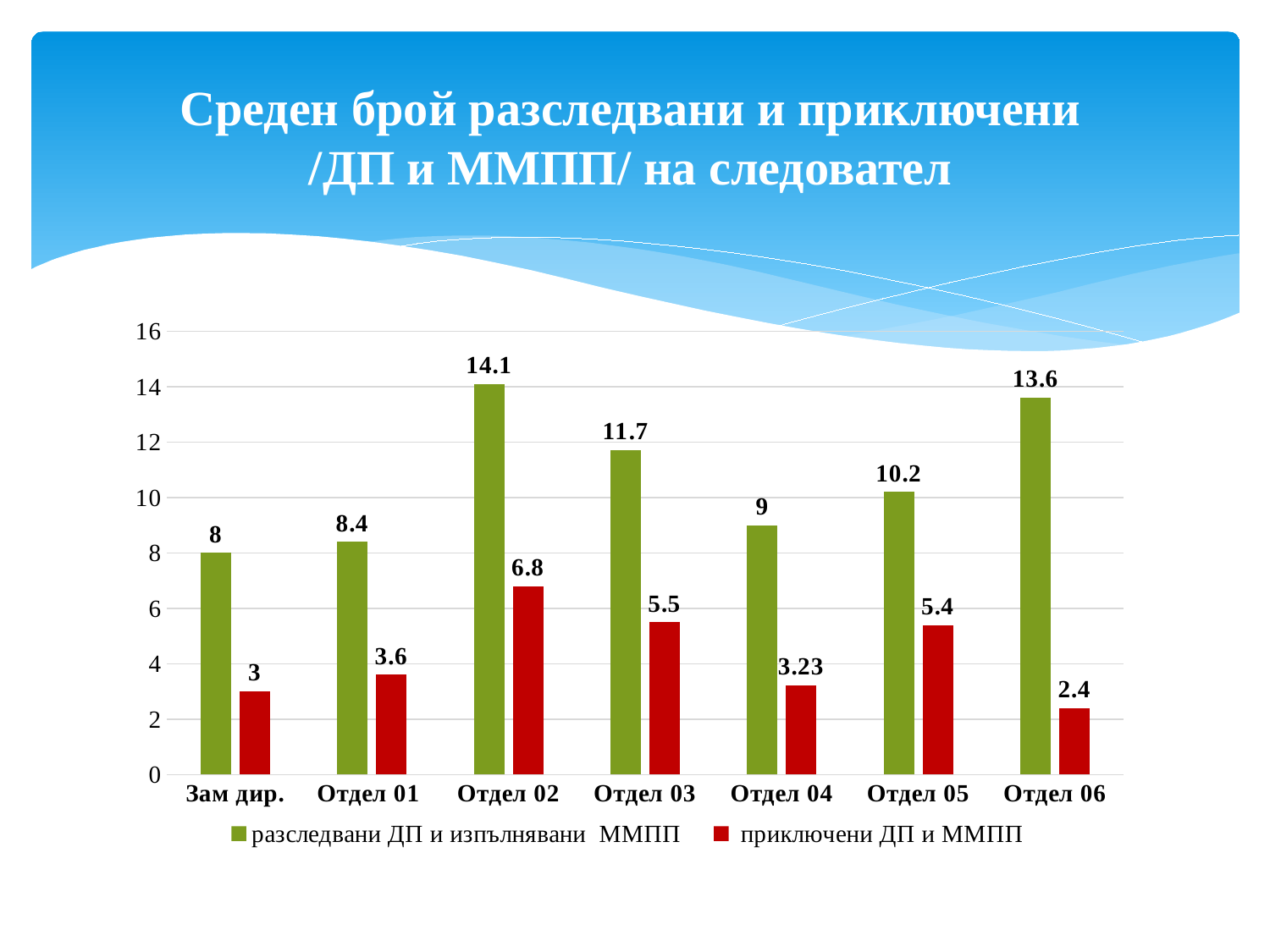
What kind of chart is shown on the slide? bar chart What is the value of "приключени ДП и ММПП" for Отдел 04? 3.23 What is the difference between the two series for Отдел 06? 11.2 What is the value of "приключени ДП и ММПП" for Зам дир.? 3 Which category has the highest value for "разследвани ДП и изпълнявани ММПП"? Отдел 02 Which category has the lowest value for "приключени ДП и ММПП"? Отдел 06 What is the value of "разследвани ДП и изпълнявани ММПП" for Отдел 02? 14.1 How many categories are shown on the x axis? 7 What colour are the bars for "приключени ДП и ММПП"? red Which is larger: "приключени ДП и ММПП" for Отдел 03 or for Отдел 05? Отдел 03 How many series does the legend list? 2 Is the value of "разследвани ДП и изпълнявани ММПП" for Отдел 05 greater or less than 10? greater